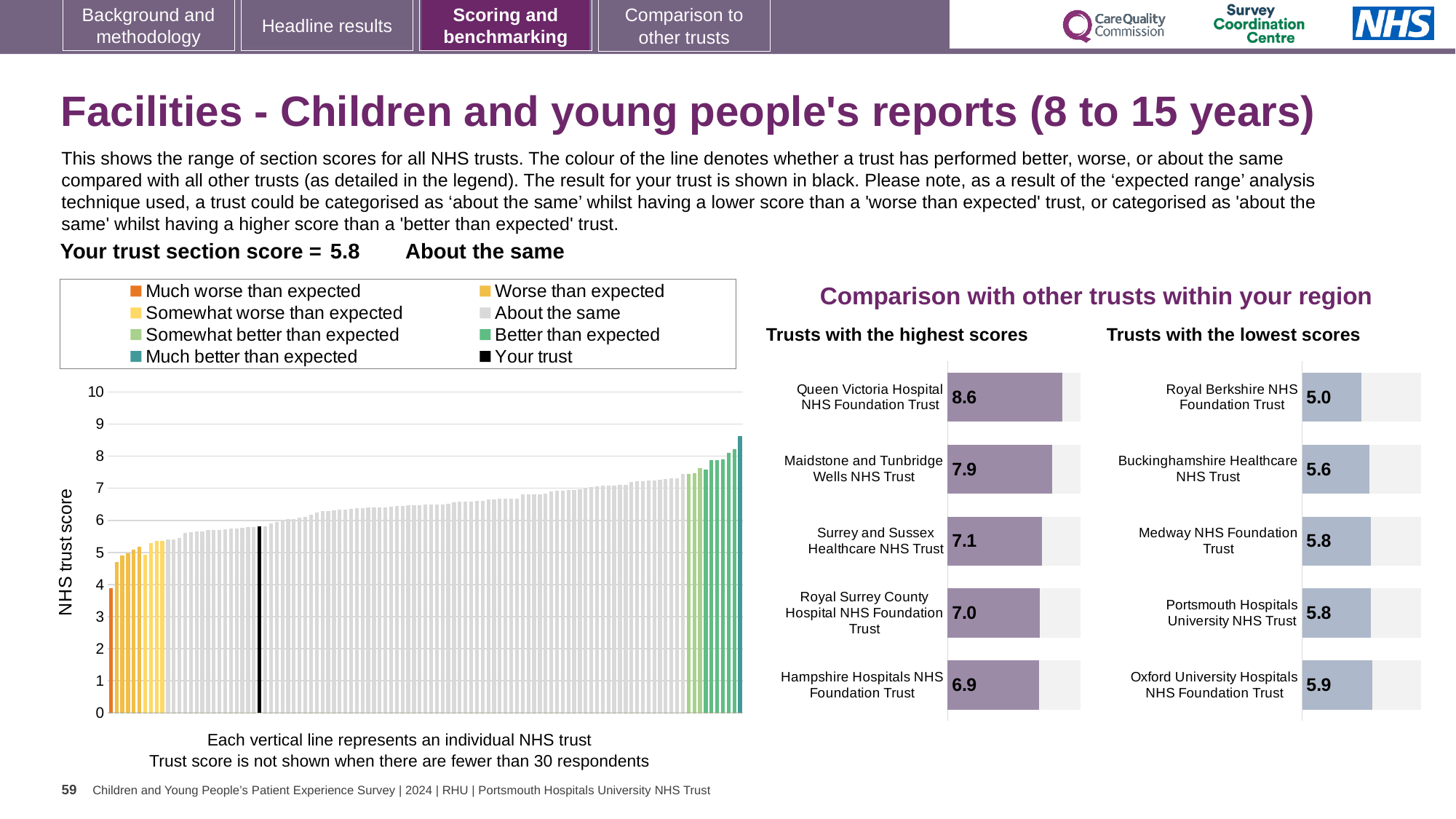
How many trusts are listed in the 'Trusts with the highest scores' chart? 5 In the 'Trusts with the lowest scores' chart, what is the score for Portsmouth Hospitals University NHS Trust? 5.8 How many entries does the legend of the large chart on the left list? 8 In the 'Trusts with the highest scores' chart, what is the difference between the scores of Queen Victoria Hospital NHS Foundation Trust and Maidstone and Tunbridge Wells NHS Trust? 0.7 In the 'Trusts with the lowest scores' chart, what is the score for Royal Berkshire NHS Foundation Trust? 5.0 In the 'Trusts with the lowest scores' chart, which has the larger score: Buckinghamshire Healthcare NHS Trust or Medway NHS Foundation Trust? Medway NHS Foundation Trust In the 'Trusts with the highest scores' chart, which trust has the lowest score shown? Hampshire Hospitals NHS Foundation Trust In the large chart on the left, do the trust scores rise or fall from left to right? Rise What kind of chart is the large chart on the left showing NHS trust scores? Bar chart In the 'Trusts with the lowest scores' chart, which trust has the highest score shown? Oxford University Hospitals NHS Foundation Trust In the 'Trusts with the highest scores' chart, what is the score for Queen Victoria Hospital NHS Foundation Trust? 8.6 In the large chart on the left, is the value of the tallest bar greater or less than 8? greater